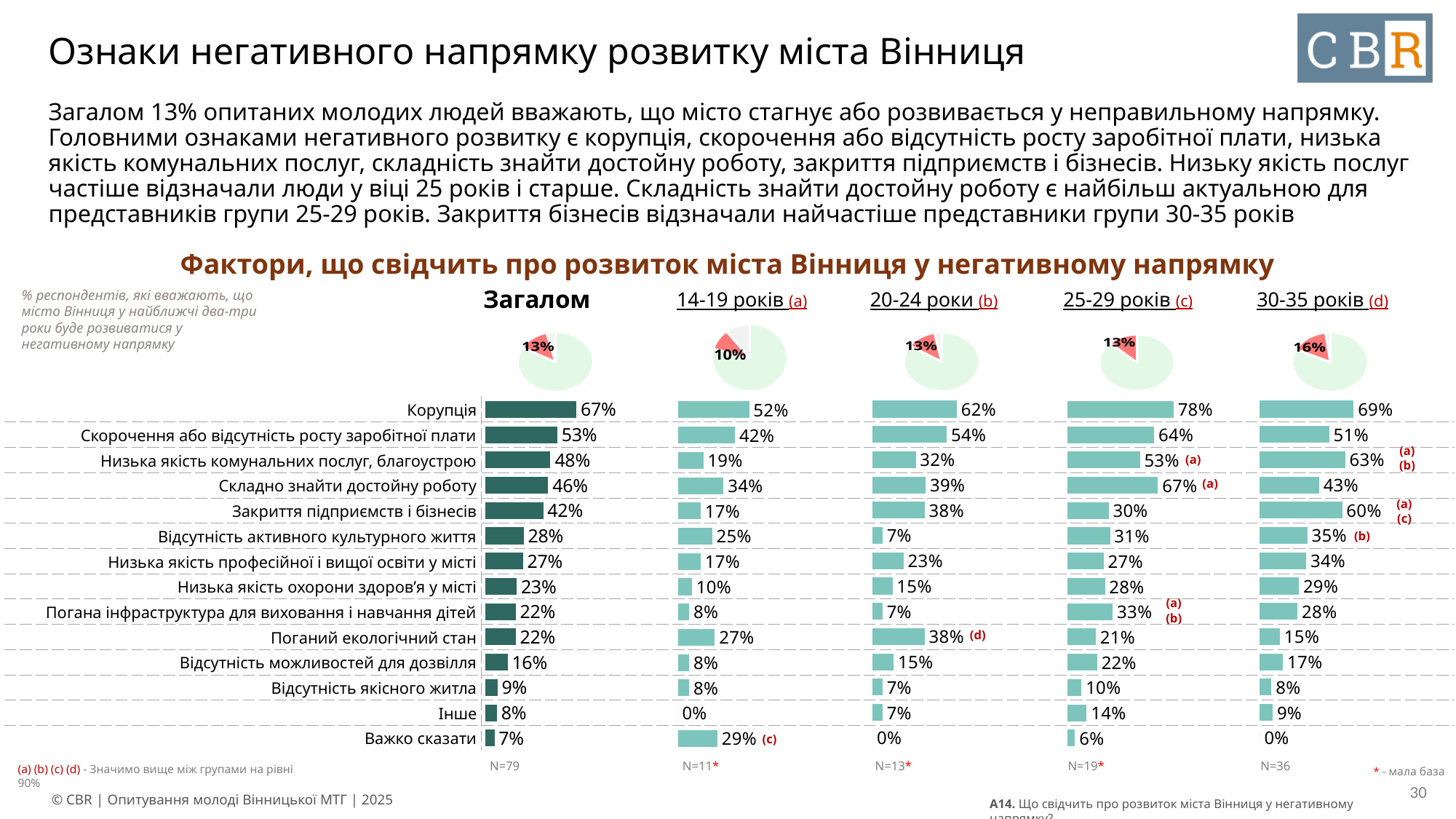
In the 'Загалом' bar chart, what is the difference between 'Корупція' and 'Скорочення або відсутність росту заробітної плати'? 14 percentage points In the '30-35 років' bar chart, which category has the highest value? Корупція In the 'Загалом' bar chart, which category has the lowest value? Важко сказати In the '25-29 років' bar chart, what is the value for 'Складно знайти достойну роботу'? 67% In the '14-19 років' bar chart, what is the value for 'Важко сказати'? 29% In the '20-24 роки' bar chart, what is the value for 'Відсутність активного культурного життя'? 7% In the 'Загалом' bar chart, what is the value for 'Корупція'? 67% What kind of chart is used to show the factors for each age group? Bar chart In the '14-19 років' bar chart, which is larger: 'Корупція' or 'Скорочення або відсутність росту заробітної плати'? Корупція How many categories are listed in the 'Загалом' bar chart? 14 What is the sample size (N) shown under the '30-35 років' bar chart? N=36 In the pie chart above the '30-35 років' column, what share of respondents think the city will develop in a negative direction? 16%